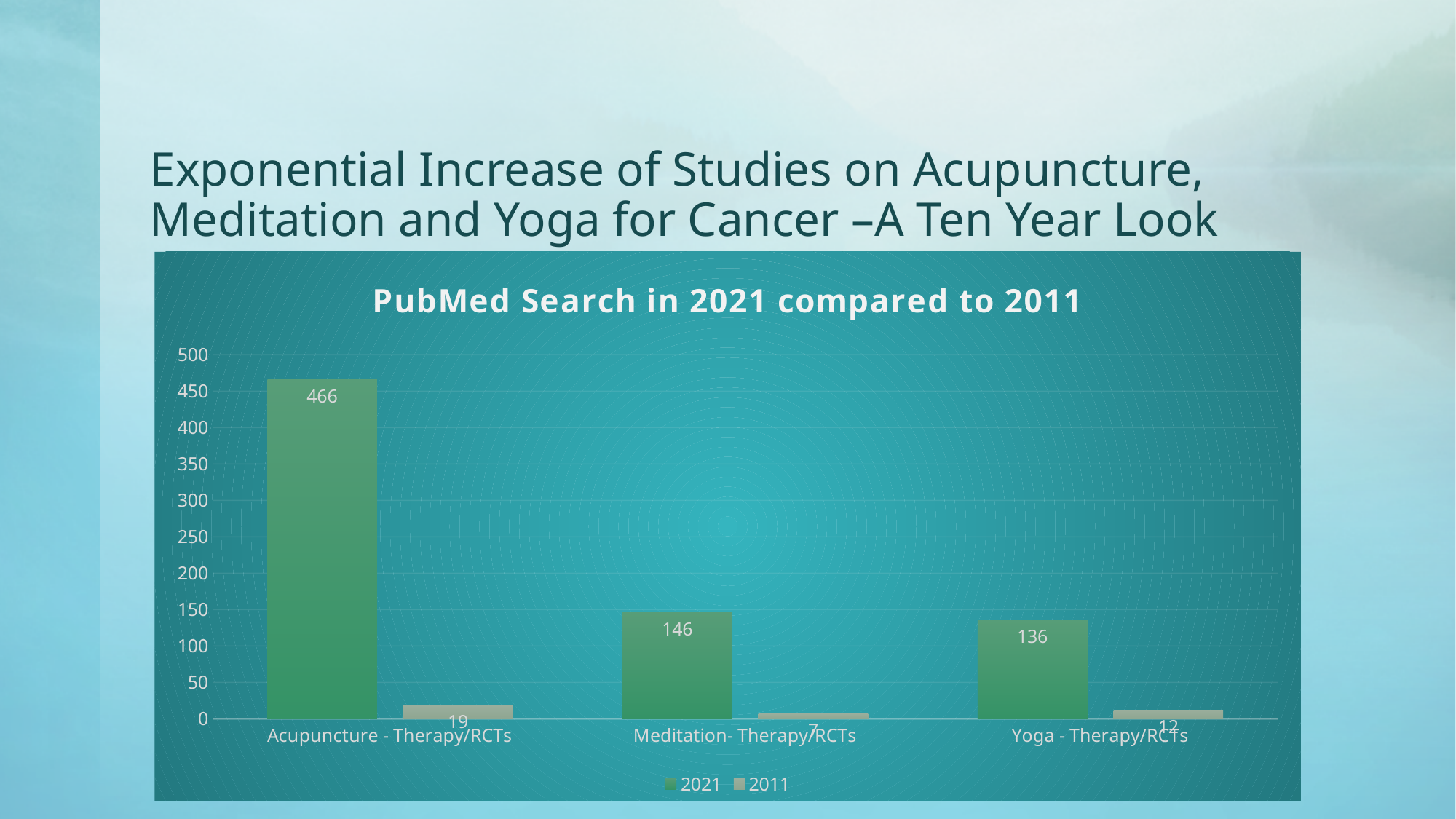
How many series does the legend list? 2 How many categories are shown on the x axis? 3 What is the 2021 value for Acupuncture - Therapy/RCTs? 466 Which is larger: the 2021 value for Meditation- Therapy/RCTs or the 2021 value for Yoga - Therapy/RCTs? Meditation- Therapy/RCTs Which category has the highest 2021 value? Acupuncture - Therapy/RCTs What is the difference between the 2021 and 2011 values for Acupuncture - Therapy/RCTs? 447 What is the 2021 value for Yoga - Therapy/RCTs? 136 Which category has the lowest 2011 value? Meditation- Therapy/RCTs What is the 2011 value for Meditation- Therapy/RCTs? 7 What is the 2011 value for Yoga - Therapy/RCTs? 12 Is the 2021 value for Meditation- Therapy/RCTs greater or less than 100? greater What is the title of the chart? PubMed Search in 2021 compared to 2011